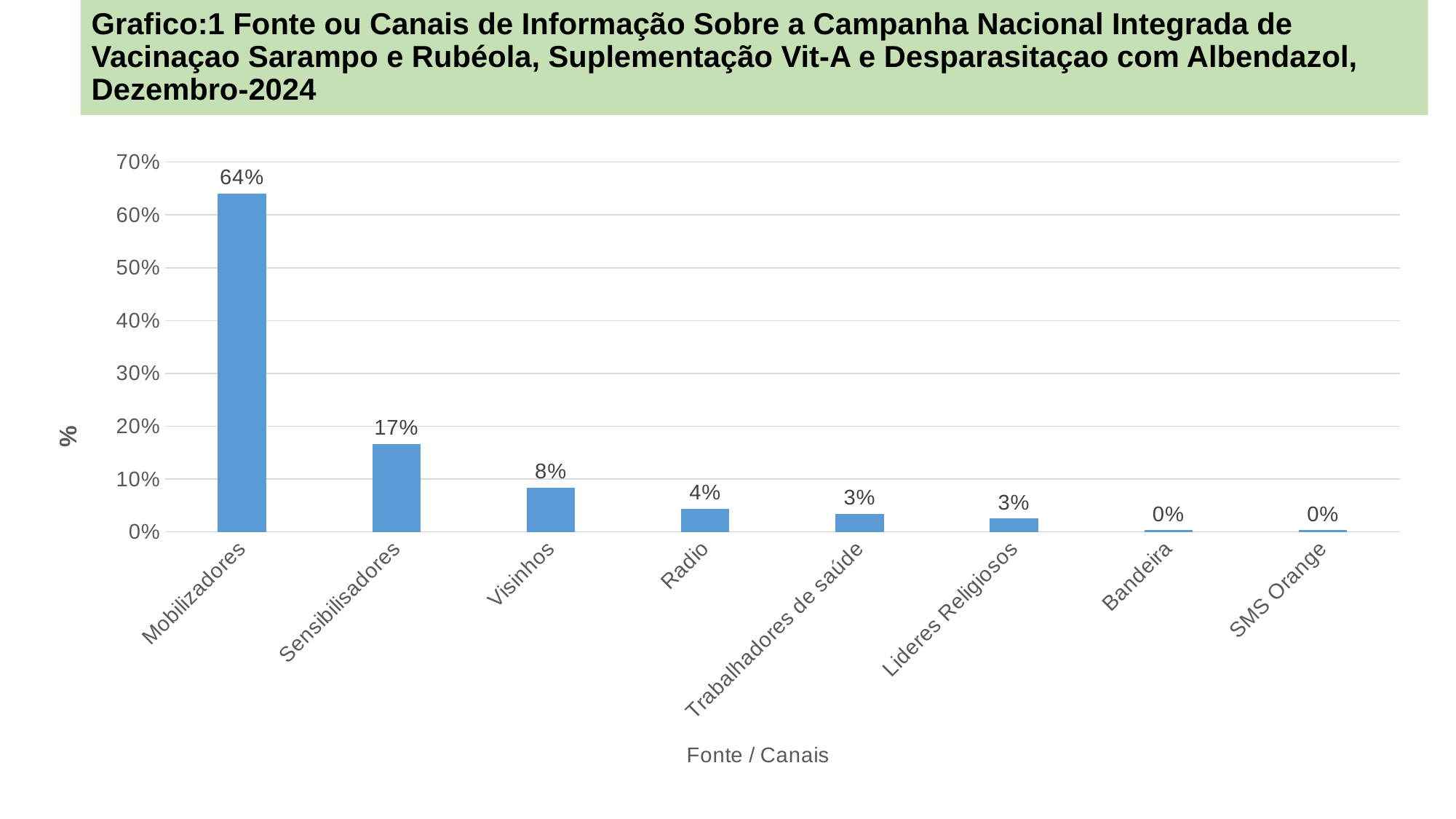
Which is larger, the value for Visinhos or the value for Radio? Visinhos What is the value for Radio? 4% What is the difference between the values for Mobilizadores and Sensibilisadores? 47% Which category has the highest value? Mobilizadores What is the value for Bandeira? 0% What is the x-axis title of the chart? Fonte / Canais How many categories are shown on the x axis? 8 What is the value for Visinhos? 8% Is the value for Mobilizadores greater or less than 60%? greater What kind of chart is shown on the slide? bar chart What is the value for Mobilizadores? 64% What is the value for Sensibilisadores? 17%